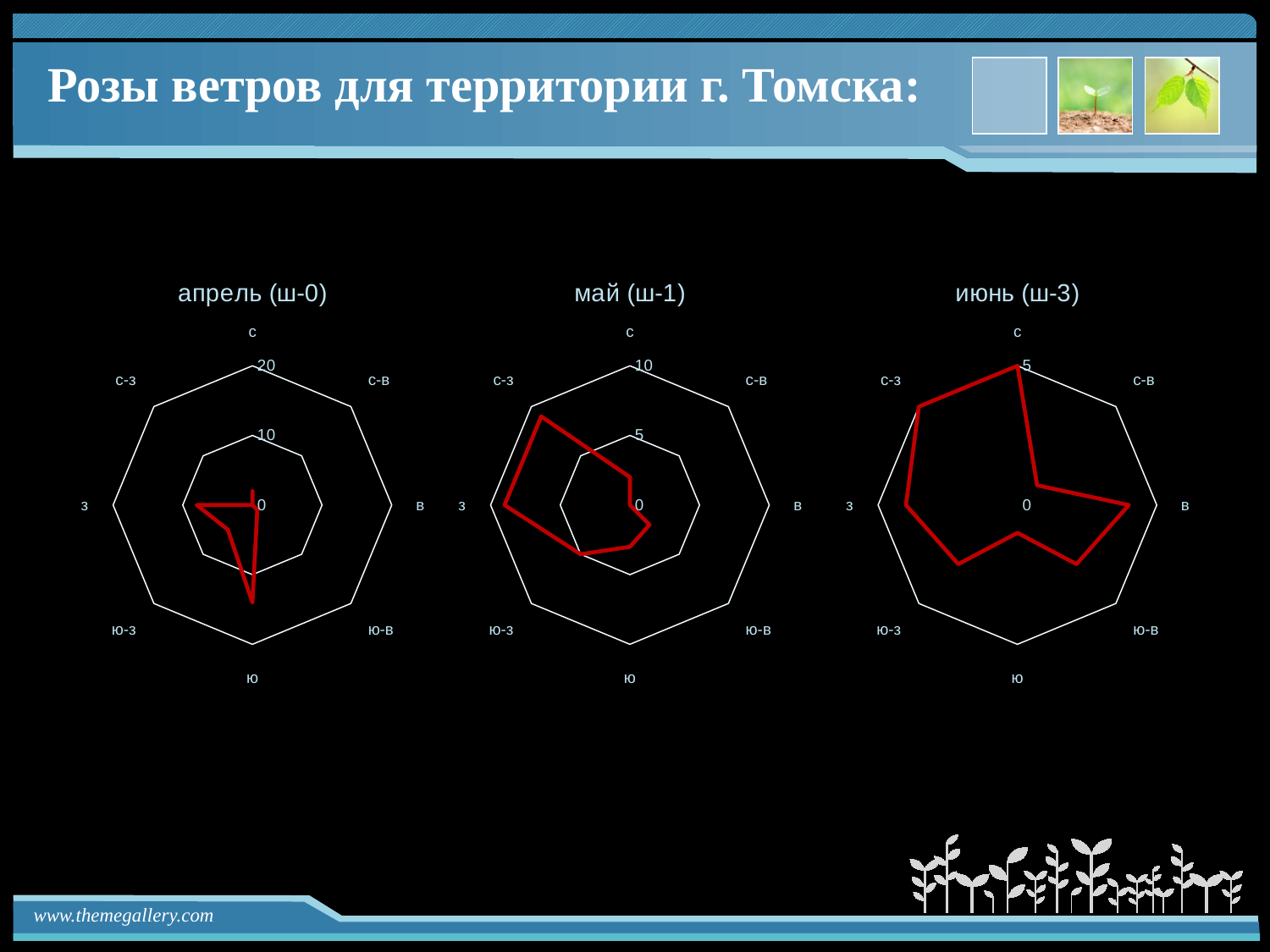
In the chart titled "апрель (ш-0)", which direction has the highest value? ю How many charts are shown on the slide? 3 In the chart titled "июнь (ш-3)", is the value for ю greater or less than 5? less In the chart titled "апрель (ш-0)", is the value for ю greater or less than 10? greater What kind of chart is used for the three wind roses on the slide? radar chart What is the outermost axis tick value shown on the chart titled "апрель (ш-0)"? 20 In the chart titled "апрель (ш-0)", is the value for з greater or less than 10? less In the chart titled "апрель (ш-0)", which is larger, the value for ю or the value for з? ю In the chart titled "апрель (ш-0)", how many direction categories are plotted around the chart? 8